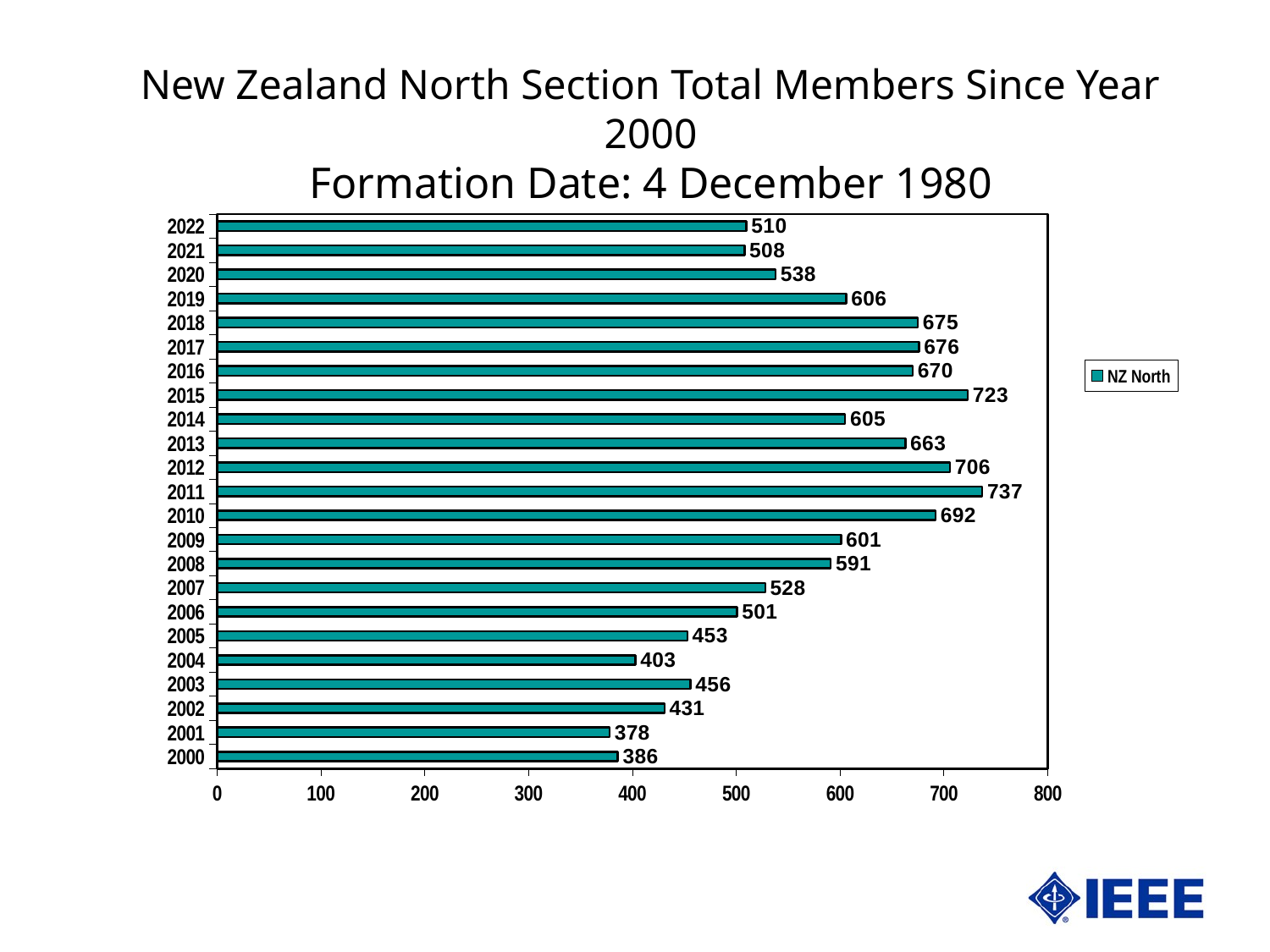
Which year had the lowest total membership? 2001 Which year had the highest total membership? 2011 Is the value for 2019 greater or less than 500? greater How many years are shown on the chart? 23 Which year had more members, 2012 or 2013? 2012 What was the total membership of the NZ North section in 2000? 386 What is the difference in membership between 2020 and 2021? 30 What is the difference in membership between 2011 and 2001? 359 How many series does the legend list? 1 What kind of chart is shown on the slide? Bar chart What was the total membership of the NZ North section in 2022? 510 What was the total membership of the NZ North section in 2015? 723